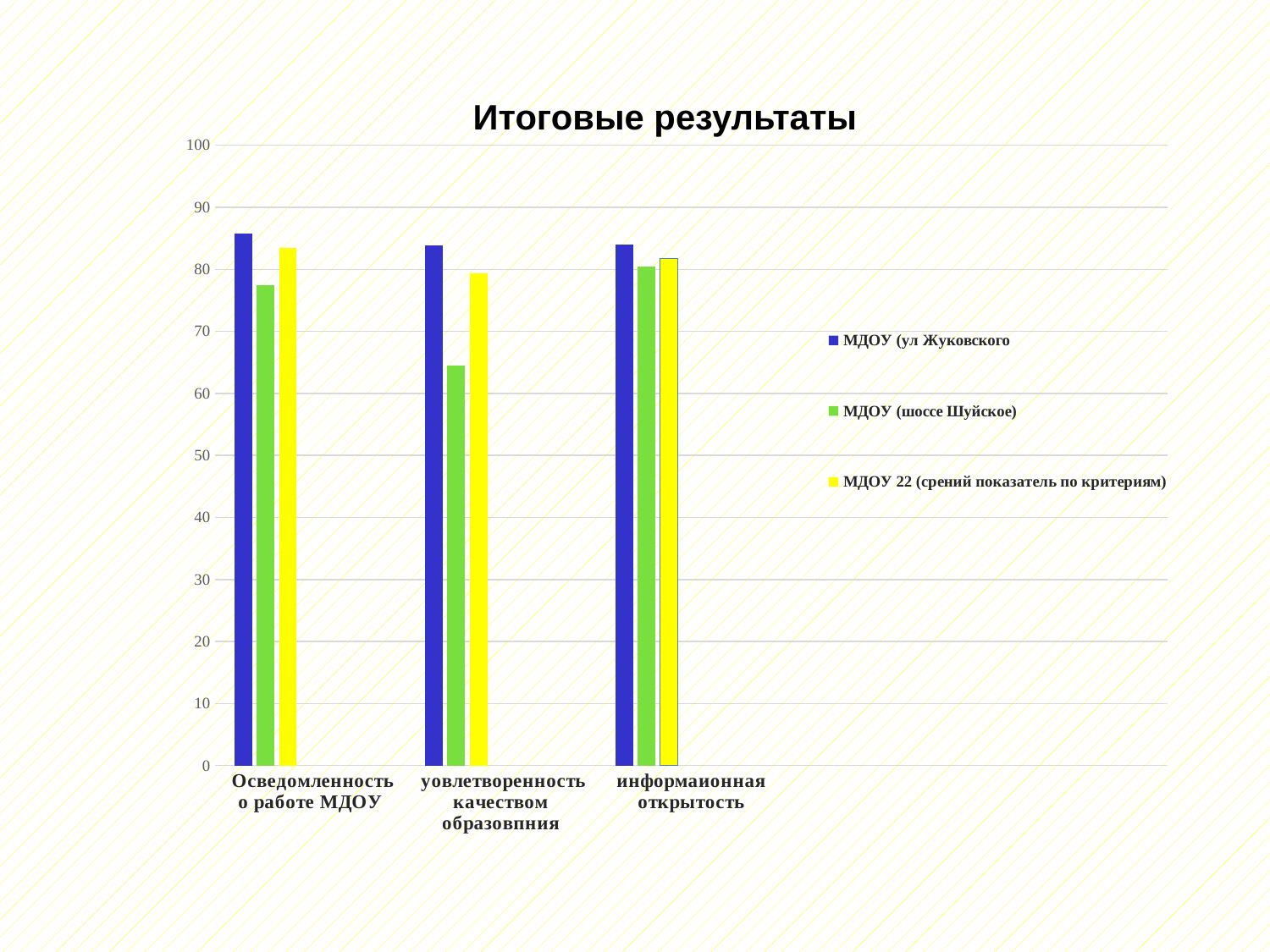
In the category 'Осведомленность о работе МДОУ', which is larger: МДОУ (шоссе Шуйское) or МДОУ 22 (срений показатель по критериям)? МДОУ 22 (срений показатель по критериям) Is the value for МДОУ (ул Жуковского) in the category 'Осведомленность о работе МДОУ' greater or less than 80? greater Which series is shown in yellow in the legend? МДОУ 22 (срений показатель по критериям) What kind of chart is shown on the slide? bar chart In the category 'уовлетворенность качеством образовпния', which is larger: МДОУ (ул Жуковского) or МДОУ (шоссе Шуйское)? МДОУ (ул Жуковского) Is the value for МДОУ (шоссе Шуйское) in the category 'уовлетворенность качеством образовпния' greater or less than 70? less For the series МДОУ (шоссе Шуйское), which category has the lowest value? уовлетворенность качеством образовпния What is the title of the chart? Итоговые результаты For the series МДОУ (шоссе Шуйское), which category has the highest value? информаионная открытость How many series does the legend list? 3 Is the value for МДОУ (шоссе Шуйское) in the category 'Осведомленность о работе МДОУ' greater or less than 80? less How many categories are shown on the x axis? 3